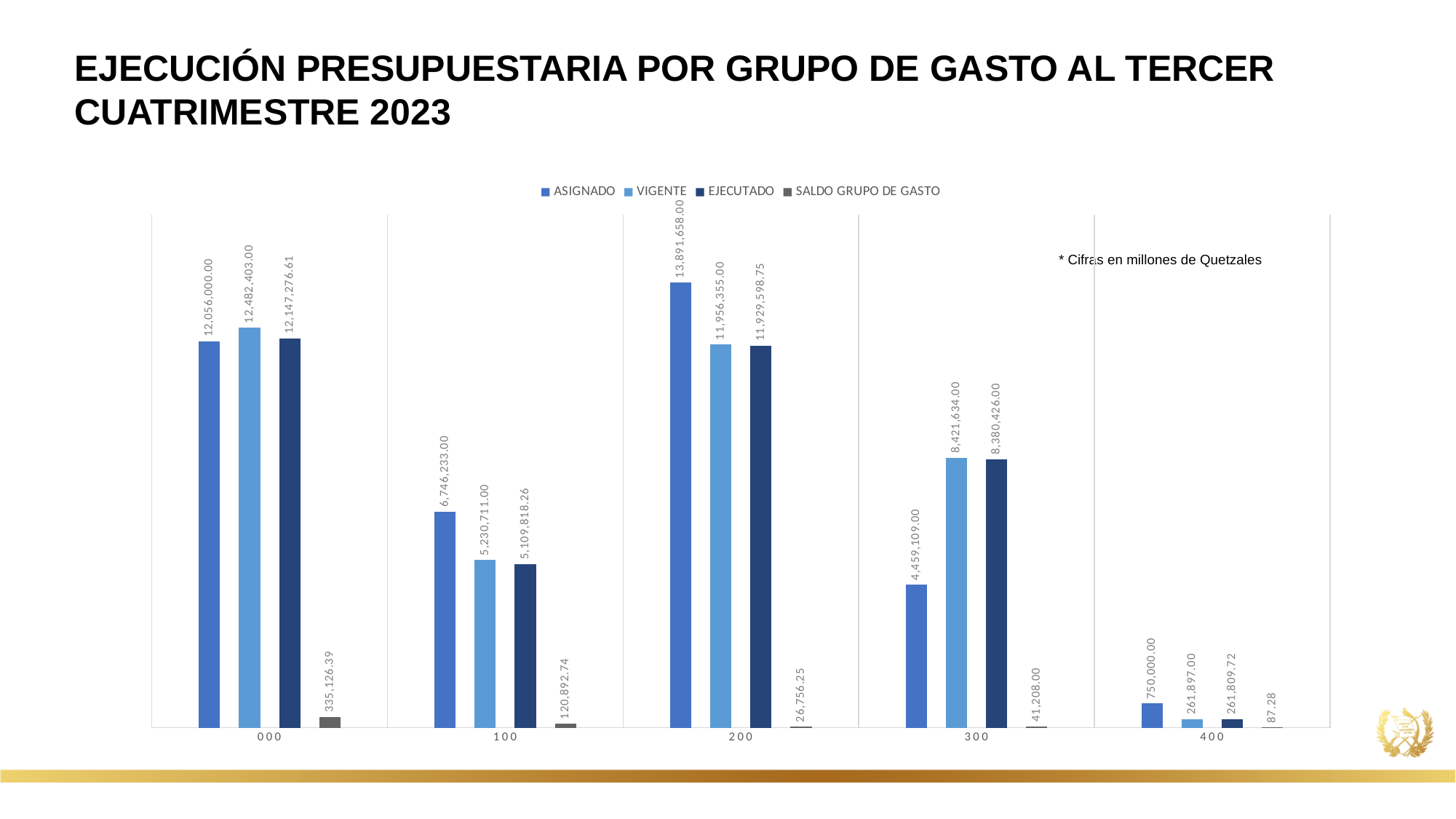
Which group has the lowest VIGENTE value? 400 What is the EJECUTADO value for group 100? 5,109,818.26 What is the difference between the ASIGNADO values for group 000 and group 100? 5,309,767.00 How many series does the legend list? 4 What is the VIGENTE value for group 000? 12,482,403.00 What is the ASIGNADO value for group 200? 13,891,658.00 Which group has the highest ASIGNADO value? 200 How many expense groups are shown on the x axis? 5 What kind of chart is shown on the slide? Bar chart For group 300, which is larger: ASIGNADO or VIGENTE? VIGENTE What is the SALDO GRUPO DE GASTO value for group 400? 87.28 What is the difference between the VIGENTE and EJECUTADO values for group 300? 41,208.00